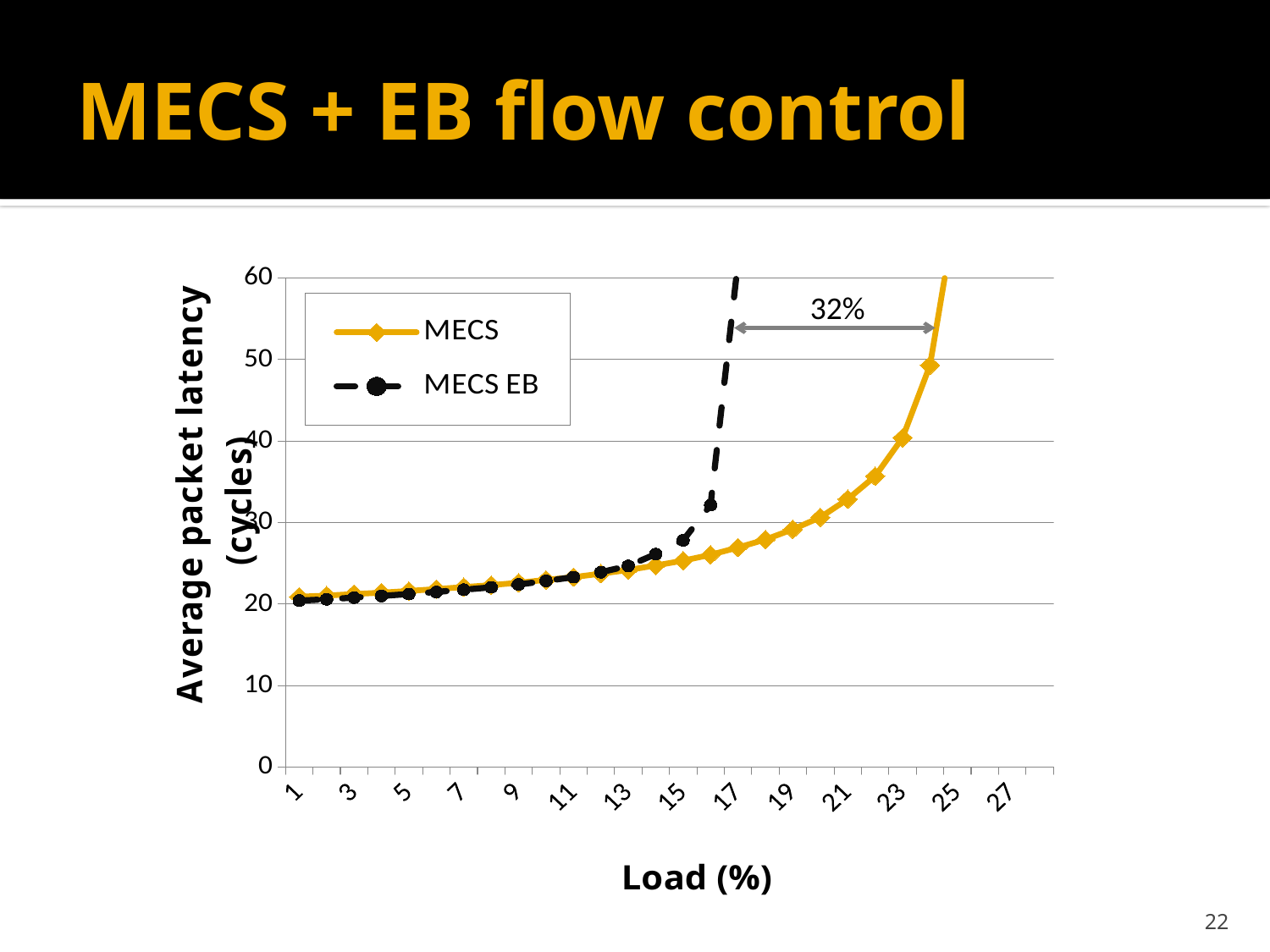
Is the average packet latency for MECS at a load of 21% greater or less than 30? greater At a load of 16%, which series has the higher average packet latency, MECS or MECS EB? MECS EB What kind of chart is shown on the slide? line chart What is the highest load value labeled on the x axis? 27 Is the average packet latency for MECS at a load of 13% greater or less than 30? less What is the label of the x axis? Load (%) Which series reaches 60 cycles of average packet latency at a lower load, MECS or MECS EB? MECS EB How many series does the legend list? 2 Does the average packet latency for MECS rise or fall as load increases? rise Is the average packet latency for MECS EB at a load of 15% greater or less than 30? less Does the average packet latency for MECS EB rise or fall as load increases? rise What are the two series named in the legend? MECS and MECS EB